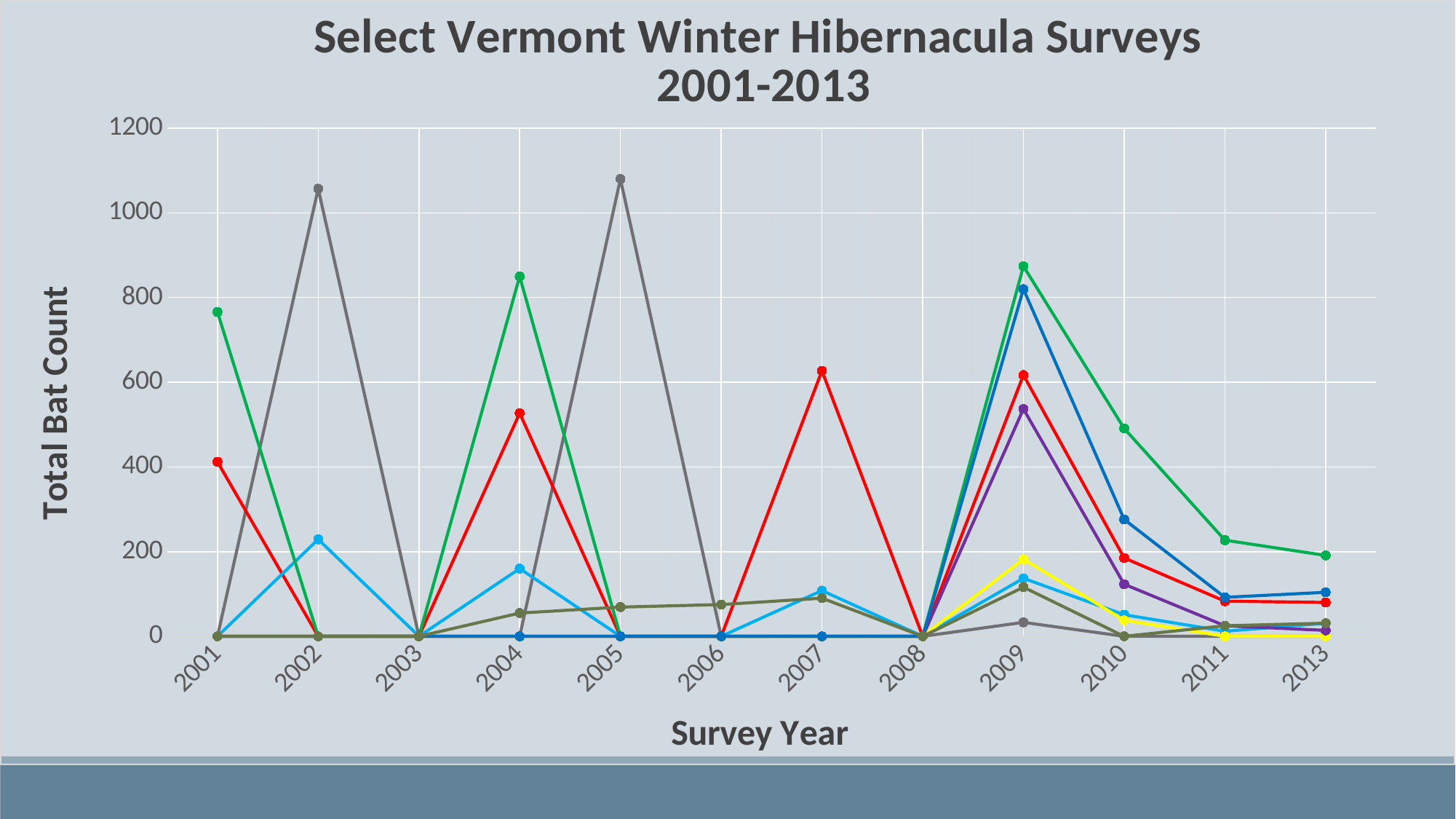
Is the value of the light blue line in 2002 greater or less than 400? less In which survey year does the dark gray line reach its highest value? 2005 In which survey year does the green line reach its highest value? 2009 How many survey years are plotted along the x axis? 12 From 2009 to 2013, does the green line rise or fall? fall What is the label on the vertical axis? Total Bat Count What is the title of the chart? Select Vermont Winter Hibernacula Surveys 2001-2013 Is the value of the red line in 2007 greater or less than 600? greater Is the value of the dark gray line in 2002 greater or less than 1000? greater What kind of chart is shown on the slide? line chart In 2009, which is higher, the green line or the red line? green line